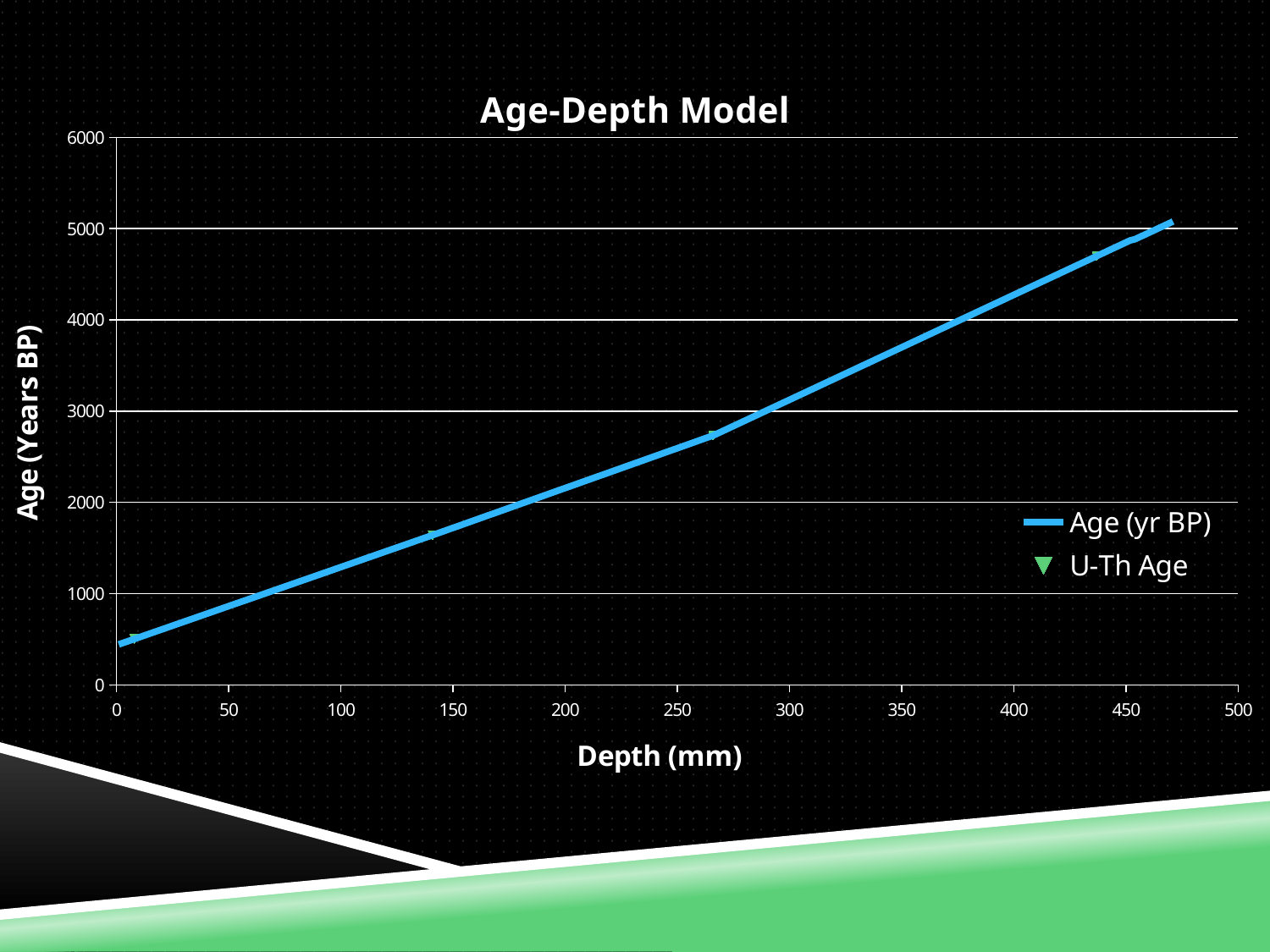
What is the title of the chart? Age-Depth Model Is the age at a depth of 350 mm greater or less than 4000 years BP? less Is the age at a depth of 400 mm greater or less than 4000 years BP? greater Is the age at a depth of 150 mm greater or less than 1000 years BP? greater Does the age rise or fall as depth increases along the x axis? rise Which is larger, the age at a depth of 100 mm or the age at a depth of 300 mm? 300 mm How many series does the legend list? 2 What kind of chart is shown on the slide? line chart What is the label of the x axis? Depth (mm) What is the maximum value shown on the y axis? 6000